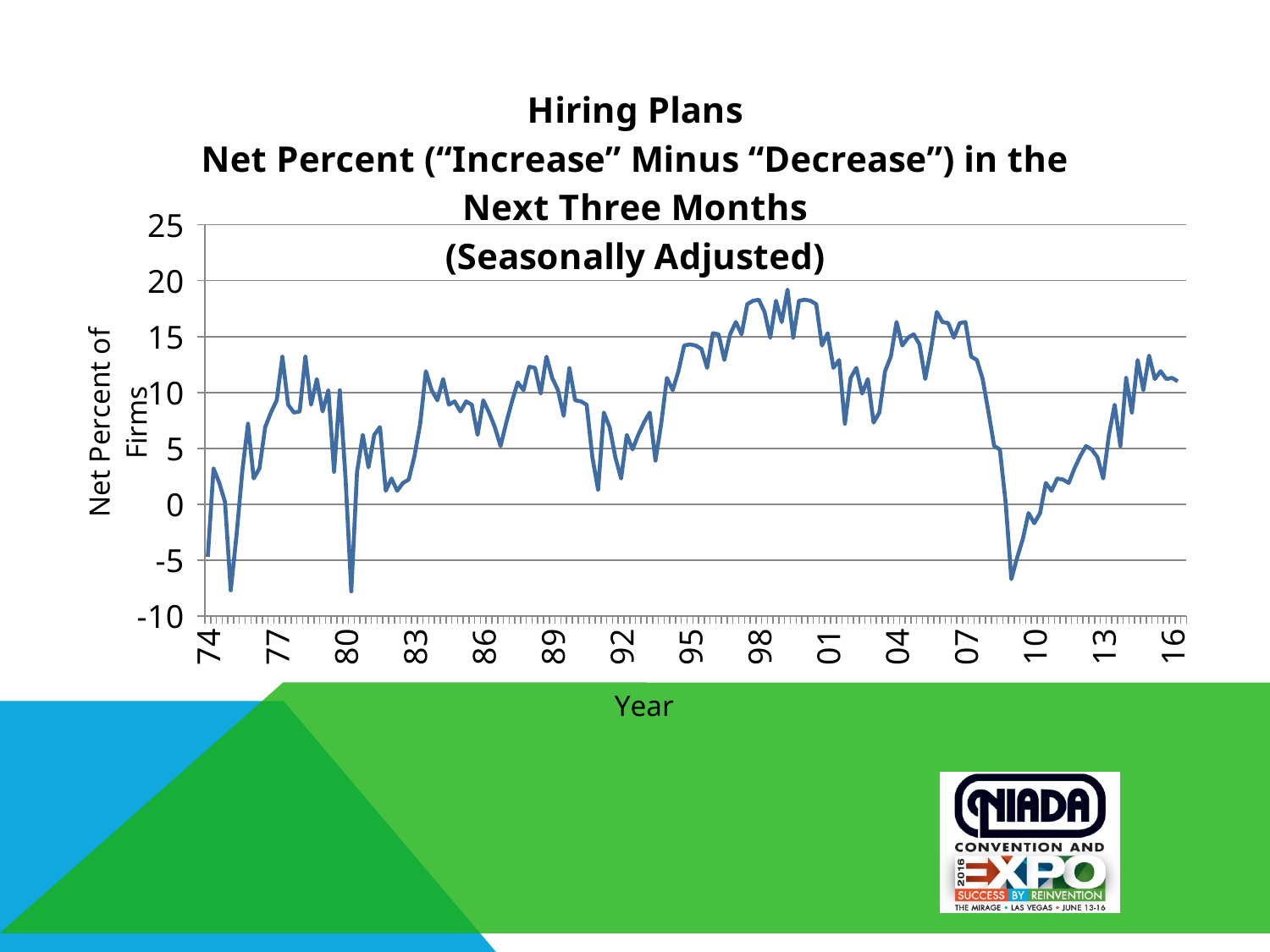
Is the value around 1975 (the dip just after the 74 tick) greater or less than 0? less What is the label on the x axis of the chart? Year Is the value around 2009 (the lowest point near the right side) greater or less than 0? less Is the value around 1980 (the dip near the 80 tick) greater or less than -5? less What is the title of the chart? Hiring Plans Net Percent ("Increase" Minus "Decrease") in the Next Three Months (Seasonally Adjusted) Do the values generally rise or fall between 2007 and 2009? fall What is the highest value shown on the y axis? 25 What kind of chart is shown on the slide? line chart How many year labels are shown along the x axis? 15 Do the values generally rise or fall between 2009 and 2013? rise